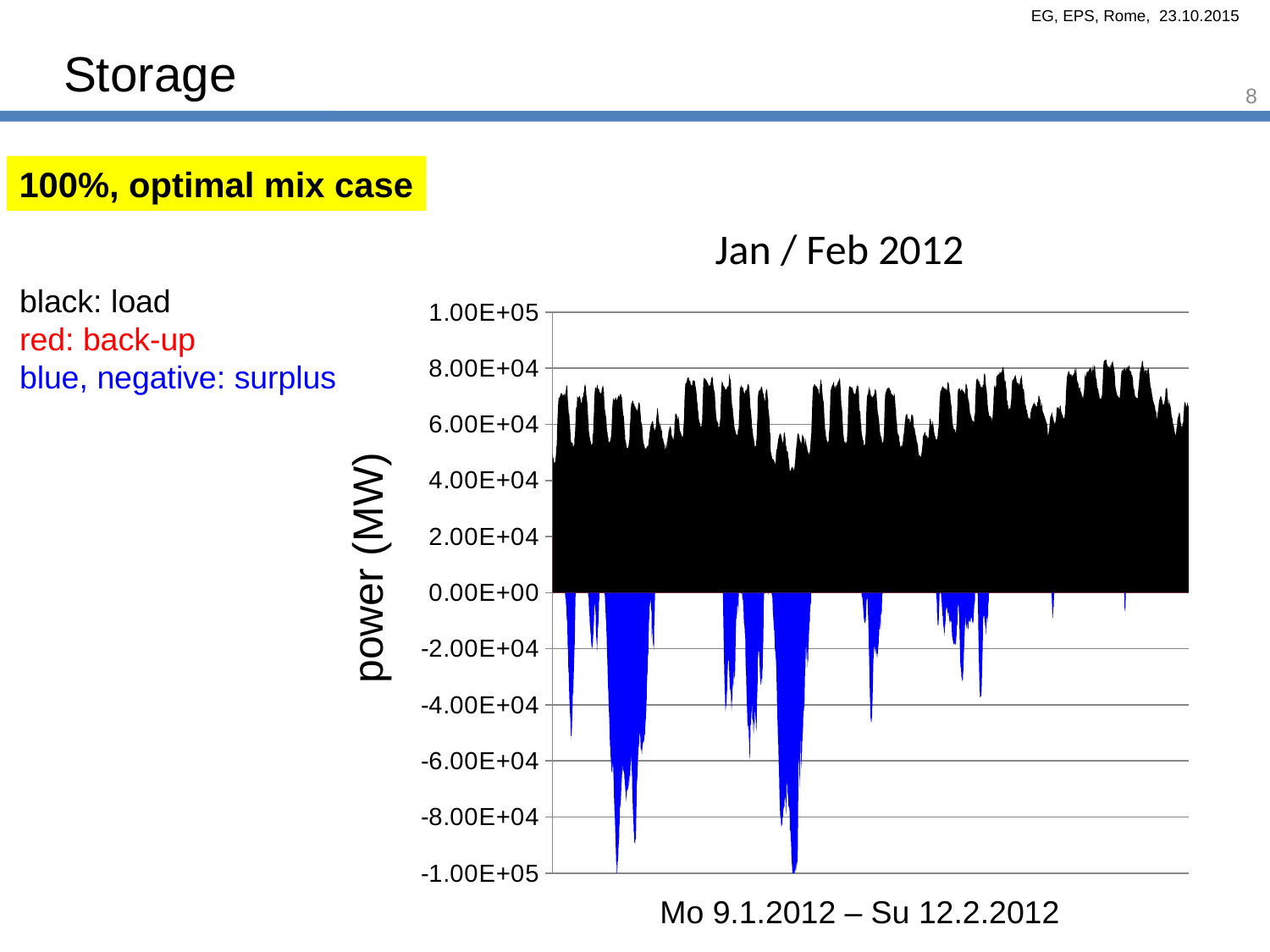
What is the label on the vertical axis of the chart? power (MW) How many series does the colour key on the slide list for the chart? 3 What is the title of the chart? Jan / Feb 2012 Which series in the chart reaches a larger absolute magnitude: the load (black) or the surplus (blue)? surplus (blue) Is the lowest surplus value (blue) in the chart greater or less than -8.00E+04? less Is the highest load value (black) in the chart greater or less than 1.00E+05? less What kind of chart is shown on the slide? area chart Is the highest load value (black) in the chart greater or less than 6.00E+04? greater